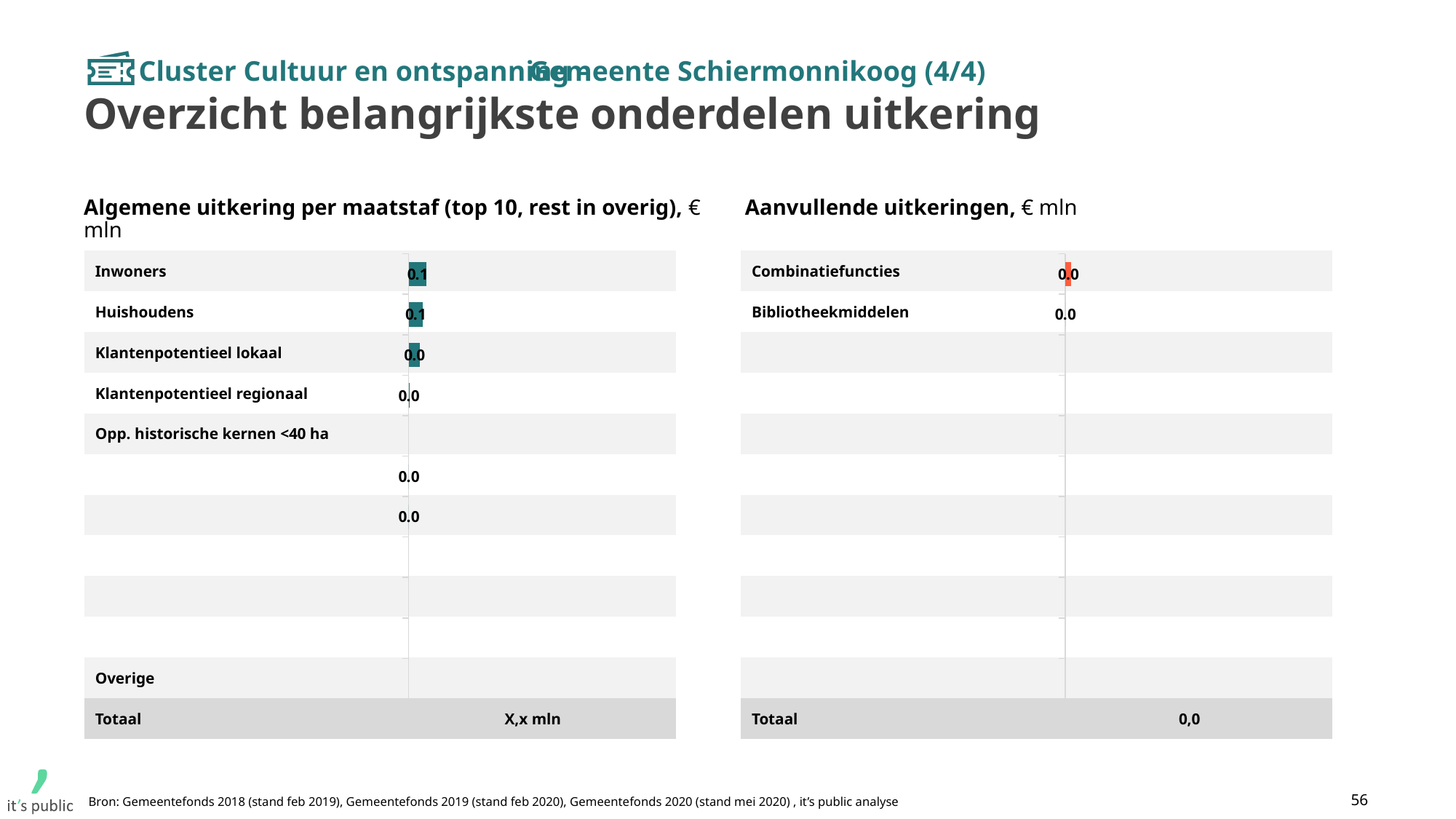
In the chart 'Algemene uitkering per maatstaf', what is the value for Klantenpotentieel lokaal? 0.0 In the chart 'Aanvullende uitkeringen', what is the value for Bibliotheekmiddelen? 0.0 In the chart 'Aanvullende uitkeringen', what is the value for Combinatiefuncties? 0.0 In the chart 'Algemene uitkering per maatstaf', what is the difference between the value for Inwoners and the value for Klantenpotentieel lokaal? 0.1 In the chart 'Algemene uitkering per maatstaf', which is larger: the value for Inwoners or the value for Klantenpotentieel lokaal? Inwoners In the chart 'Algemene uitkering per maatstaf', what is the value for Klantenpotentieel regionaal? 0.0 In the chart 'Algemene uitkering per maatstaf', what is the value for Inwoners? 0.1 What colour are the bars in the chart 'Algemene uitkering per maatstaf' on the left? Teal What kind of chart is the chart 'Algemene uitkering per maatstaf' on the left? Bar chart In the chart 'Aanvullende uitkeringen', what is the Totaal shown at the bottom? 0,0 How many labelled categories does the chart 'Aanvullende uitkeringen' on the right show? 2 In the chart 'Algemene uitkering per maatstaf', what is the value for Huishoudens? 0.1